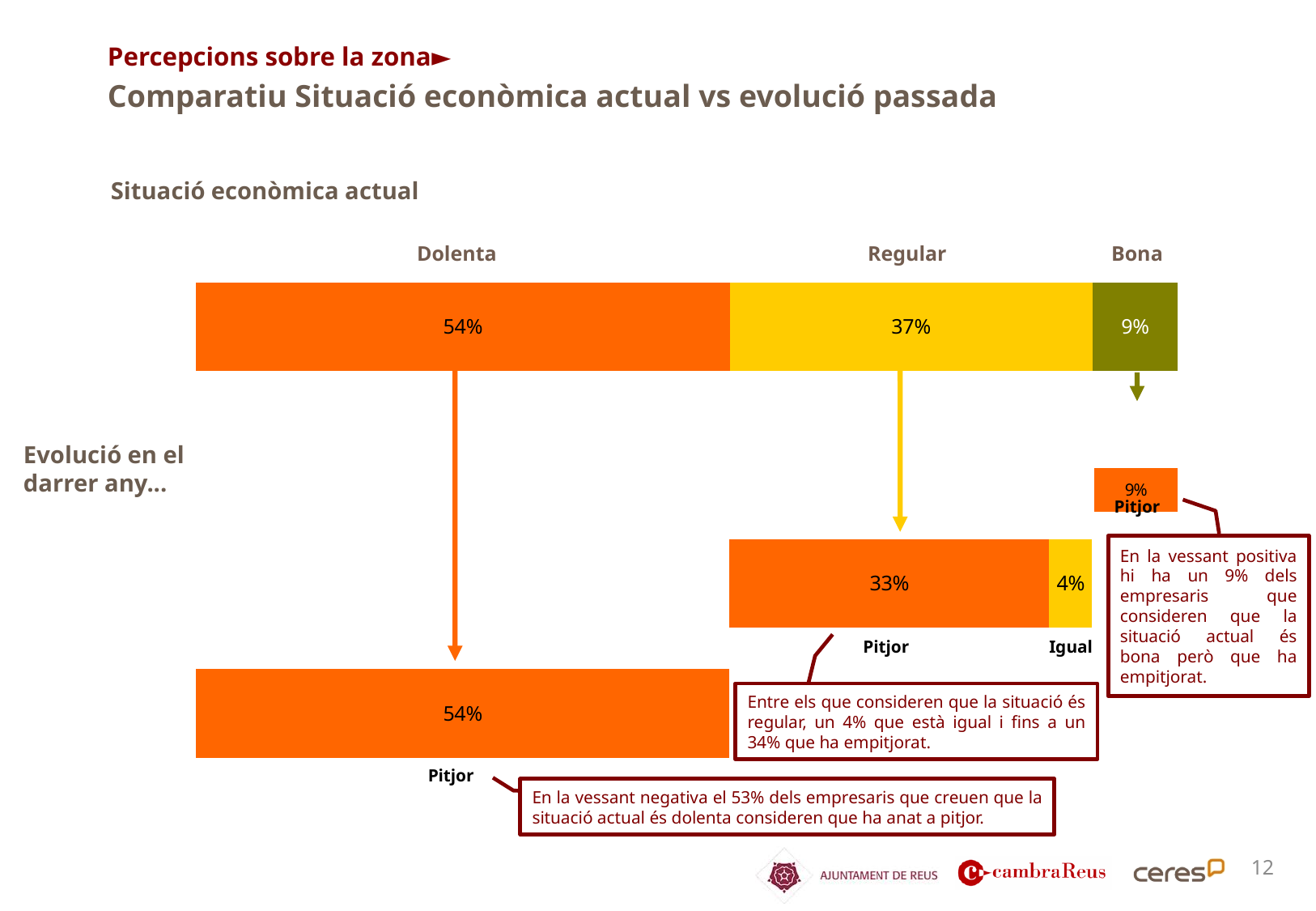
In the 'Situació econòmica actual' bar at the top, what percentage is shown for Regular? 37% In the evolution bar below Regular, which is larger, Pitjor or Igual? Pitjor In the 'Situació econòmica actual' bar at the top, which category has the largest share? Dolenta How many categories are shown in the 'Situació econòmica actual' bar at the top? 3 In the 'Situació econòmica actual' bar at the top, which category has the smallest share? Bona In the 'Situació econòmica actual' bar at the top, what percentage is shown for Bona? 9% What kind of chart is used for 'Situació econòmica actual' at the top of the slide? Stacked bar chart In the 'Situació econòmica actual' bar at the top, what is the difference between the Dolenta and Regular percentages? 17% In the 'Situació econòmica actual' bar at the top, what percentage is shown for Dolenta? 54% In the evolution bar below Regular, what percentage is labelled Pitjor? 33% In the evolution bar below Regular, what percentage is labelled Igual? 4% In the evolution bar below Dolenta, what percentage is labelled Pitjor? 54%